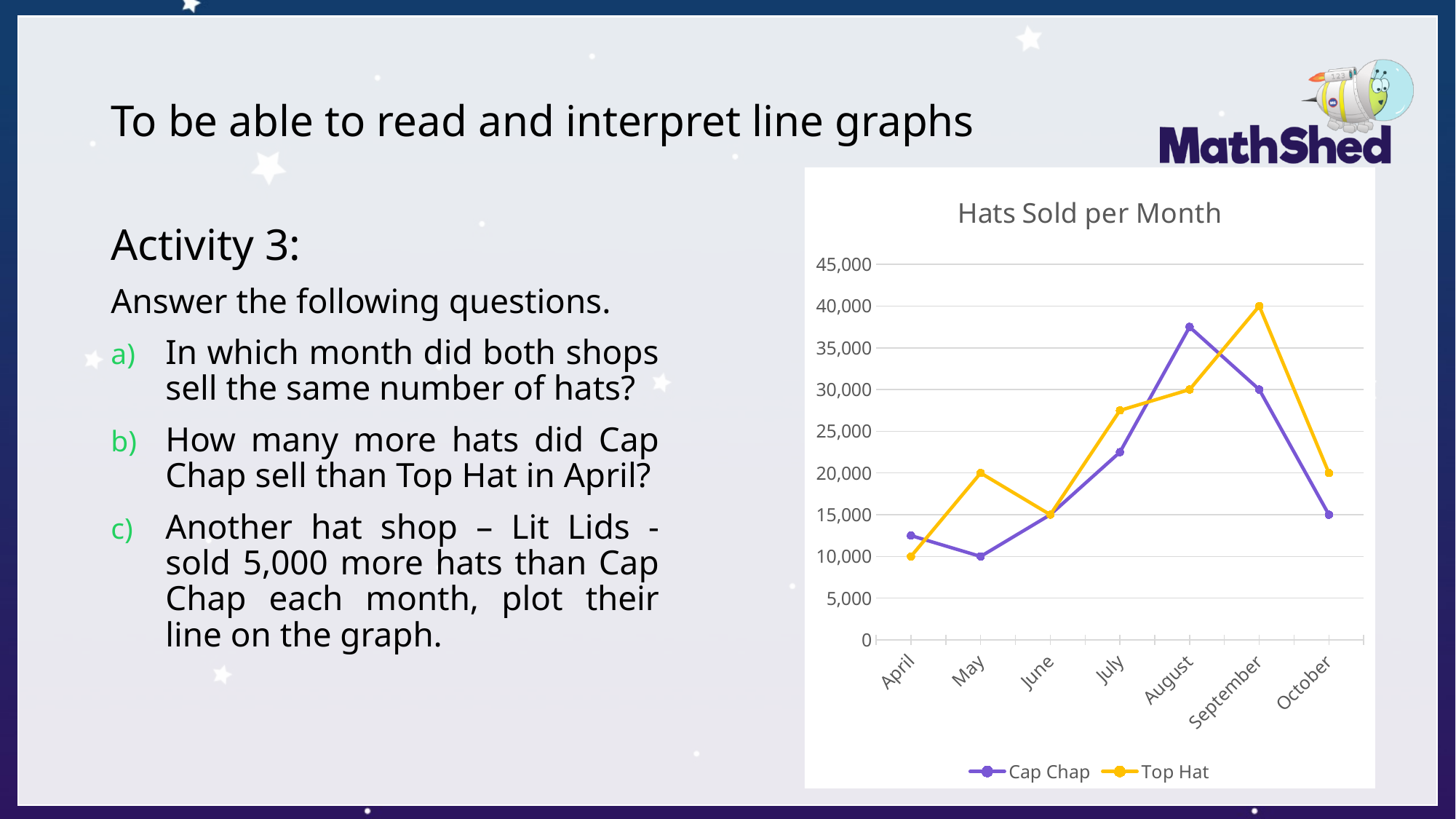
What type of chart is shown on the slide? line chart In which month did Top Hat sell the most hats? September How many series does the legend of the Hats Sold per Month chart list? 2 Is the value for Cap Chap in July greater or less than 20,000? greater How many hats did Cap Chap sell in October? 15,000 How many hats did Top Hat sell in September? 40,000 In which month did Cap Chap sell the fewest hats? May How many hats did Top Hat sell in April? 10,000 Do Top Hat's sales rise or fall from September to October? fall Which shop sold more hats in August, Cap Chap or Top Hat? Cap Chap What is the difference between Top Hat's sales in September and October? 20,000 How many months are plotted along the x axis of the chart? 7